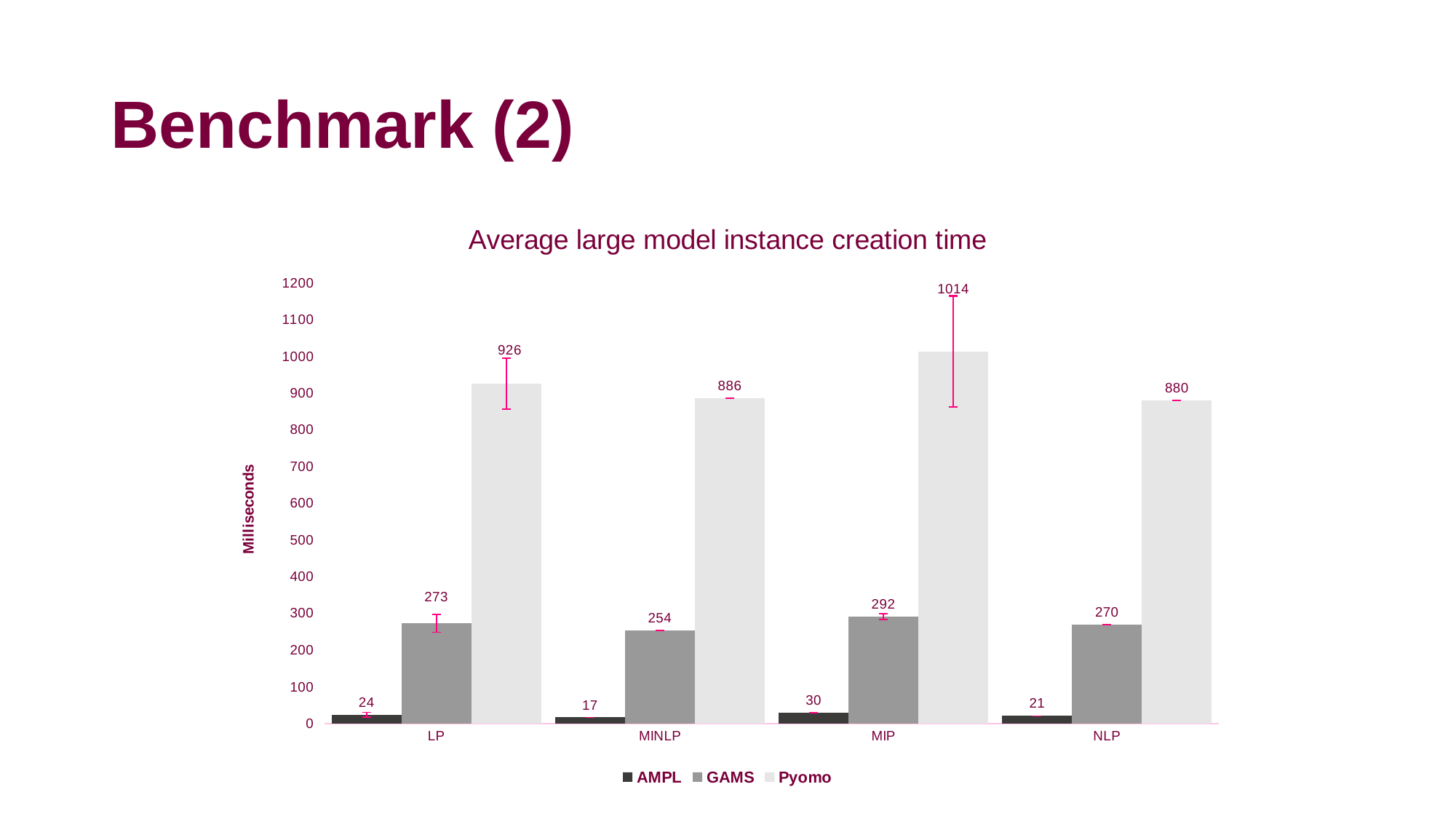
What is the title of the chart? Average large model instance creation time What kind of chart is shown on the slide? bar chart Which is larger, the GAMS value for MIP or the GAMS value for NLP? GAMS value for MIP How many categories are shown on the x axis? 4 Which category has the lowest AMPL value? MINLP What is the difference between the Pyomo and GAMS values for LP? 653 Which category has the highest Pyomo value? MIP How many series does the legend list? 3 What is the GAMS value for MINLP? 254 What is the Pyomo value for MIP? 1014 Is the Pyomo value for NLP greater or less than 900? less What is the AMPL value for NLP? 21